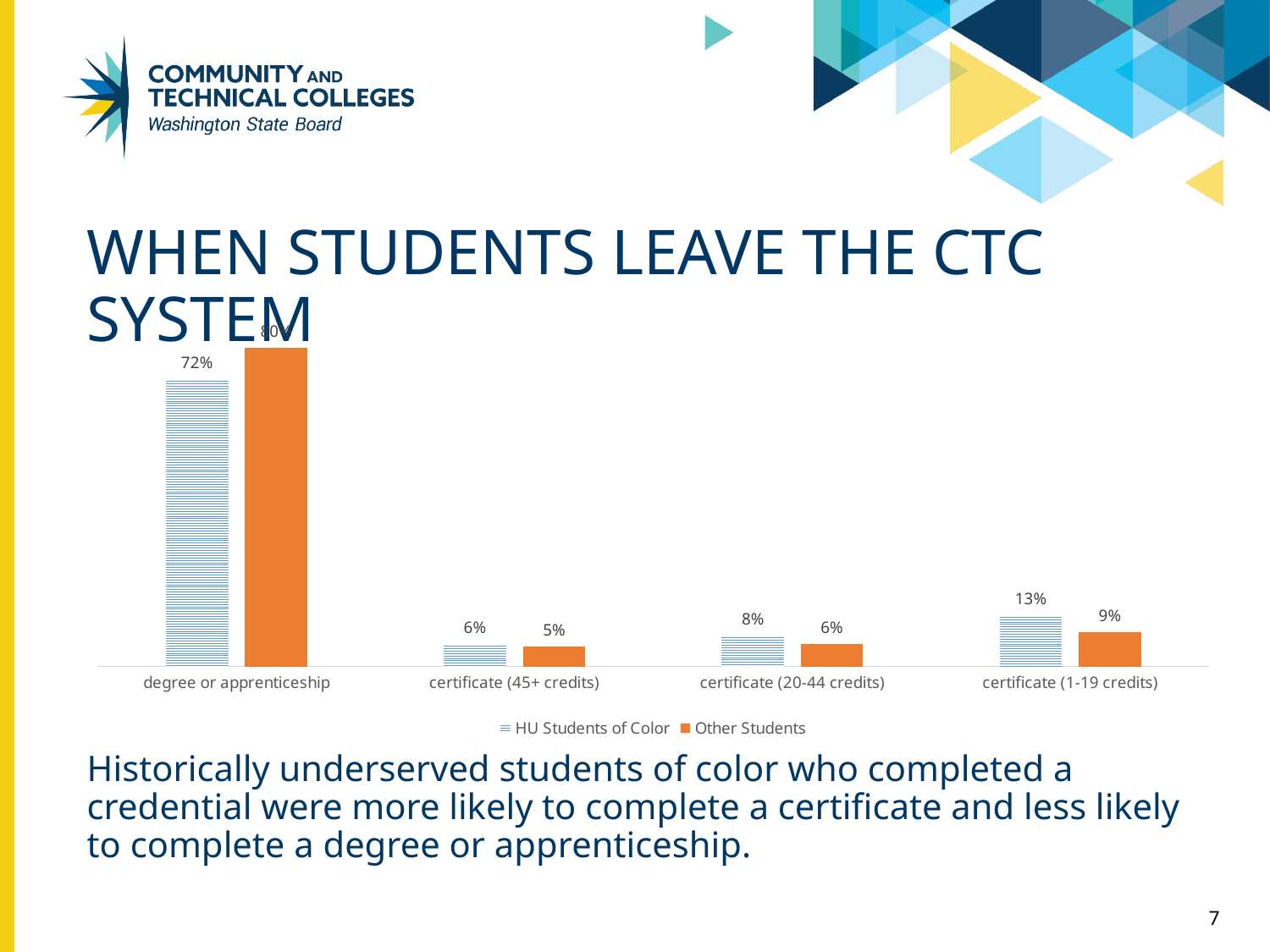
In the certificate (20-44 credits) category, which series has the larger value? HU Students of Color Which category has the highest value for Other Students? degree or apprenticeship How many categories are shown on the x axis? 4 What is the difference between HU Students of Color and Other Students in the certificate (1-19 credits) category? 4% What is the value for HU Students of Color in the degree or apprenticeship category? 72% What is the value for HU Students of Color in the certificate (20-44 credits) category? 8% What is the value for Other Students in the certificate (1-19 credits) category? 9% In the degree or apprenticeship category, which series has the larger value? Other Students What kind of chart is shown on the slide? bar chart Which category has the lowest value for HU Students of Color? certificate (45+ credits) What is the value for Other Students in the certificate (45+ credits) category? 5% How many series does the legend list? 2